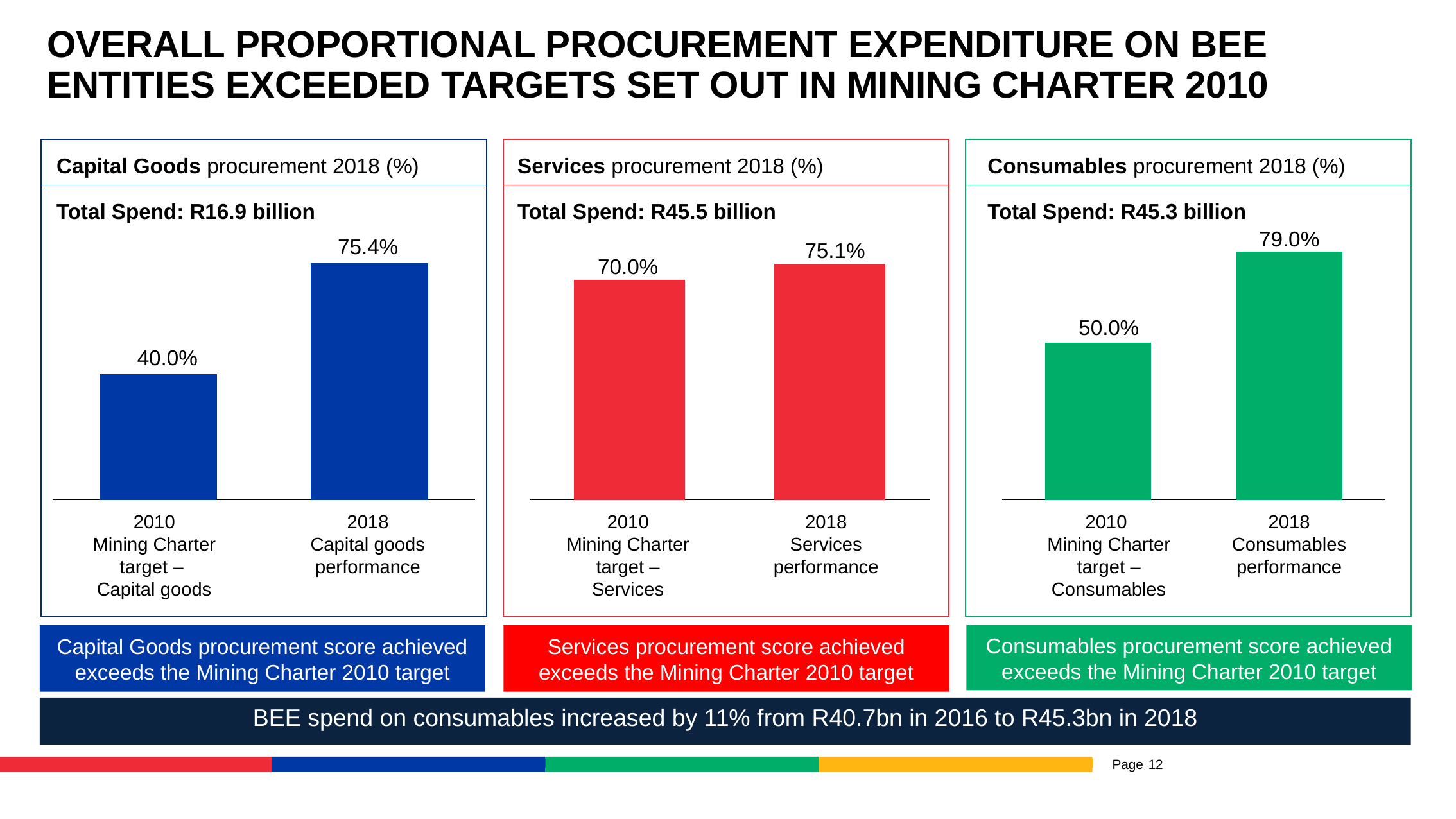
How many bars are shown in the Services procurement 2018 (%) chart? 2 In the Consumables procurement 2018 (%) chart, which bar is the lowest? 2010 Mining Charter target – Consumables In the Services procurement 2018 (%) chart, what is the value for the 2018 Services performance bar? 75.1% In the Services procurement 2018 (%) chart, which bar is higher, the 2010 Mining Charter target or the 2018 Services performance? 2018 Services performance In the Capital Goods procurement 2018 (%) chart, what is the value for the 2018 Capital goods performance bar? 75.4% In the Capital Goods procurement 2018 (%) chart, what is the difference between the 2018 Capital goods performance and the 2010 Mining Charter target? 35.4% In the Services procurement 2018 (%) chart, do the values rise or fall from 2010 to 2018? Rise What type of chart is the Capital Goods procurement 2018 (%) chart? Bar chart In the Consumables procurement 2018 (%) chart, what is the value for the 2010 Mining Charter target – Consumables bar? 50.0% In the Capital Goods procurement 2018 (%) chart, what is the value for the 2010 Mining Charter target – Capital goods bar? 40.0% In the Consumables procurement 2018 (%) chart, what is the difference between the 2018 Consumables performance and the 2010 Mining Charter target? 29.0% What total spend is stated in the Services procurement 2018 (%) chart? R45.5 billion